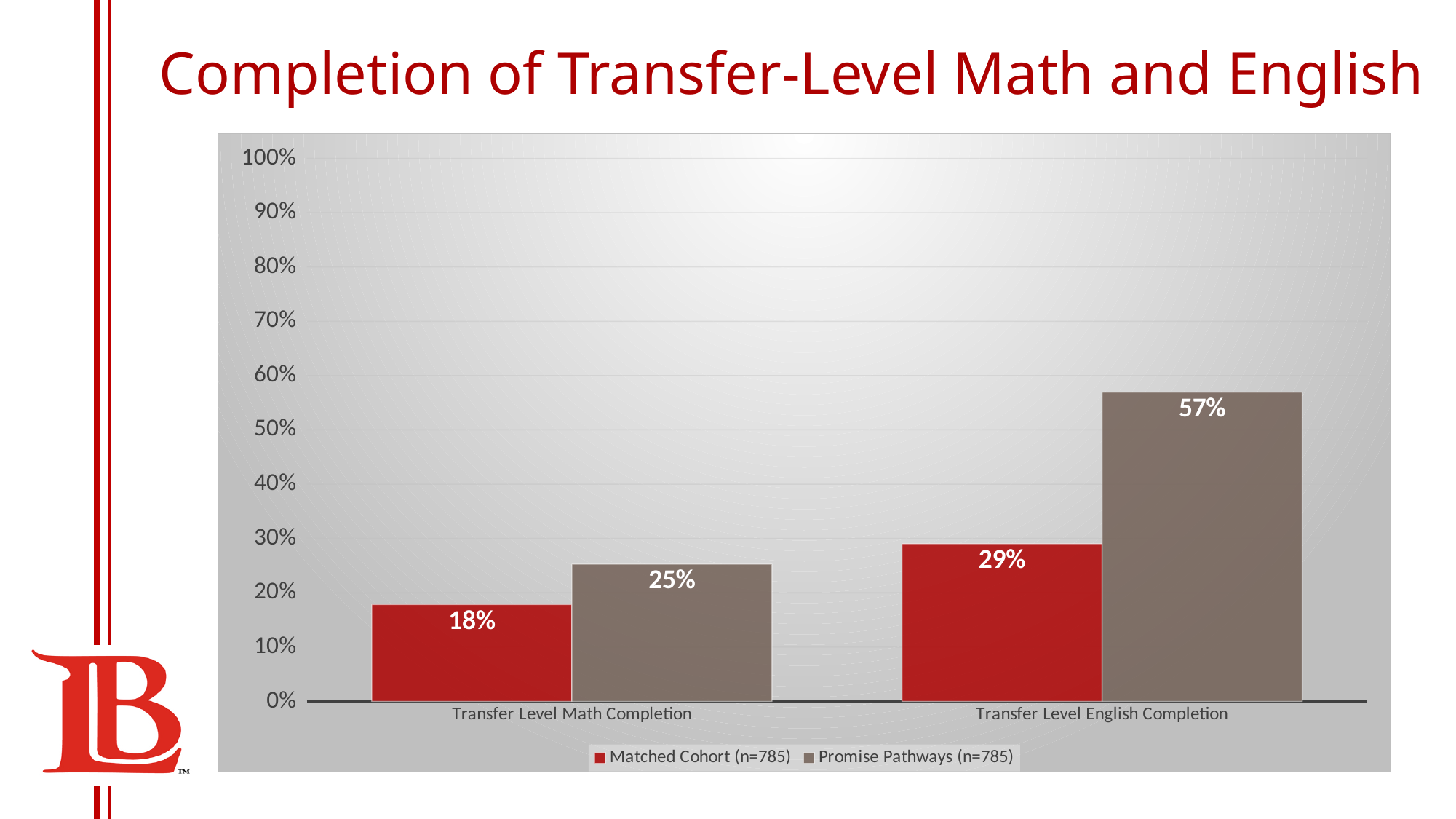
What is the Transfer Level English Completion rate for Promise Pathways (n=785)? 57% What is the Transfer Level Math Completion rate for Promise Pathways (n=785)? 25% Which series has the highest value in the chart? Promise Pathways (n=785) How many series does the legend list? 2 What is the difference between Promise Pathways and the Matched Cohort for Transfer Level Math Completion? 7% What is the Transfer Level Math Completion rate for the Matched Cohort (n=785)? 18% Which bar shows the lowest value in the chart? Matched Cohort (n=785), Transfer Level Math Completion Which is larger: the Matched Cohort's Transfer Level English Completion or Promise Pathways' Transfer Level Math Completion? Matched Cohort's Transfer Level English Completion What kind of chart is shown on the slide? Bar chart How many categories are shown on the x axis? 2 What is the difference between Promise Pathways and the Matched Cohort for Transfer Level English Completion? 28% What is the Transfer Level English Completion rate for the Matched Cohort (n=785)? 29%